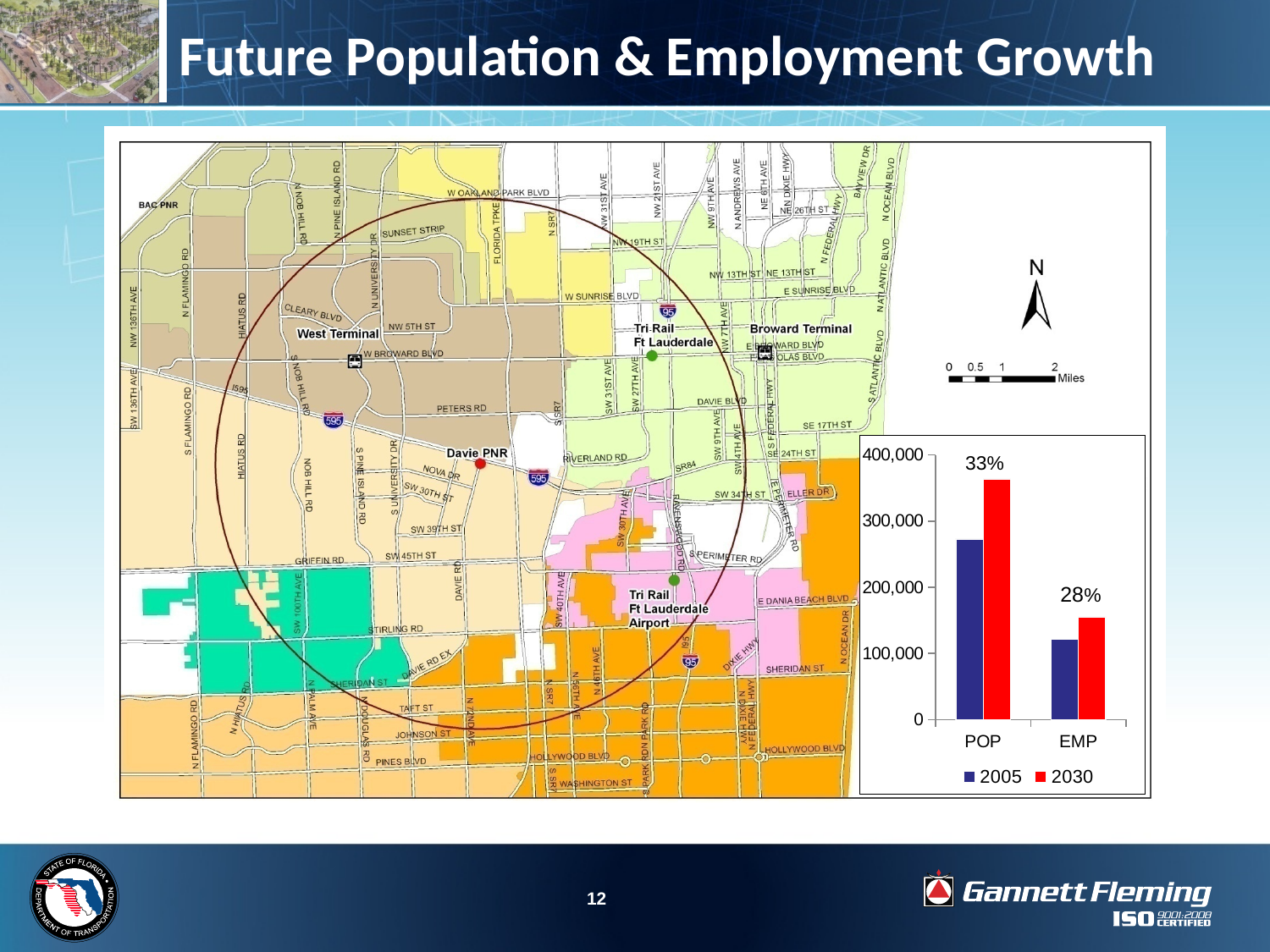
What kind of chart is shown on the right side of the slide? bar chart In the bar chart, which category has the tallest bar? POP What are the two series named in the legend of the bar chart? 2005 and 2030 What percentage label is printed above the POP bars in the bar chart? 33% In the bar chart, which is larger for POP: the 2005 value or the 2030 value? 2030 In the bar chart, which colour represents the 2030 series? red How many categories are shown on the x axis of the bar chart? 2 In the bar chart, is the 2030 value for EMP greater or less than 200,000? less How many series does the legend of the bar chart list? 2 In the bar chart, is the 2005 value for POP greater or less than 300,000? less In the bar chart, is the 2030 value for POP greater or less than 300,000? greater What percentage label is printed above the EMP bars in the bar chart? 28%